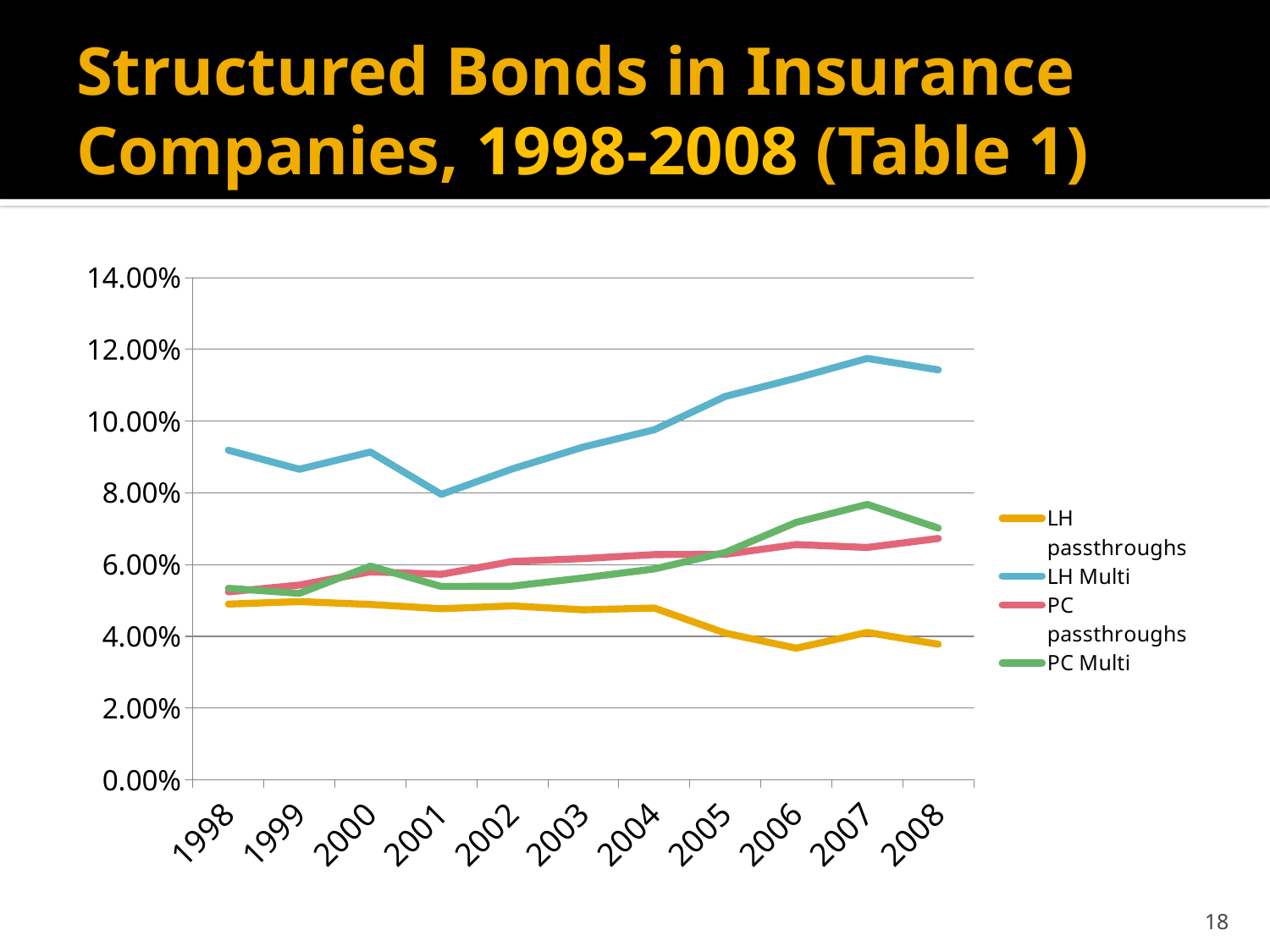
Which series has the lowest value in 2008? LH passthroughs Does the LH passthroughs series generally rise or fall from 1998 to 2008? fall Is the value for LH Multi in 2007 greater or less than 10.00%? greater What colour is the LH Multi line? blue Is the value for PC Multi in 2007 greater or less than 6.00%? greater How many series does the legend list? 4 What kind of chart is shown on the slide? line chart How many years are shown along the x axis? 11 Which series has the highest value in 2008? LH Multi Which is larger in 2007, PC Multi or PC passthroughs? PC Multi In which year does LH Multi reach its highest value? 2007 Is the value for LH passthroughs in 2006 greater or less than 4.00%? less